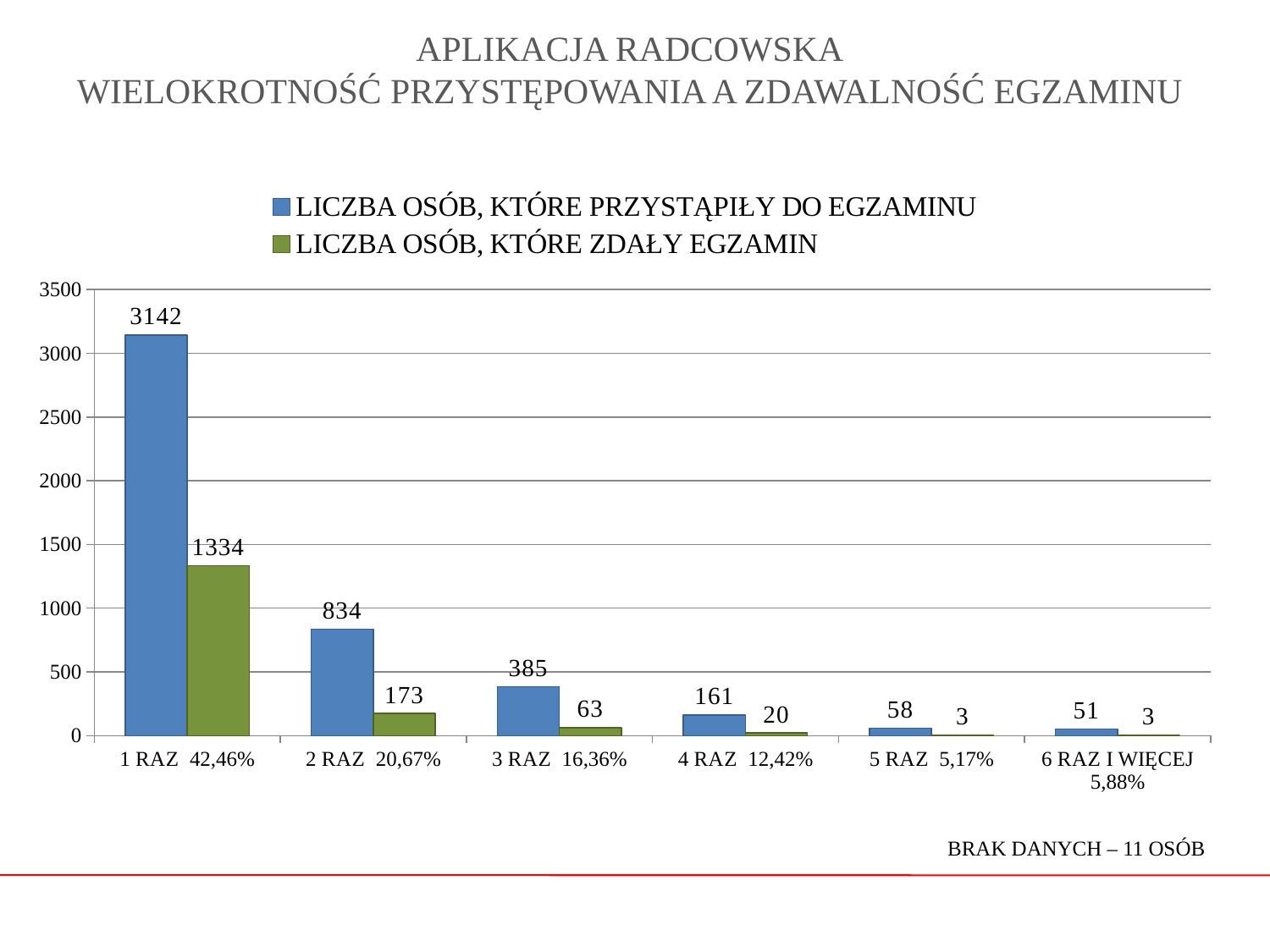
What is the difference between the number of people who took the exam and the number who passed in the 1 RAZ category? 1808 Which category has the lowest number of people who took the exam? 6 RAZ I WIĘCEJ 5,88% What is the number of people who took the exam in the 4 RAZ category? 161 Does the number of people who took the exam rise or fall from 1 RAZ to 6 RAZ I WIĘCEJ? fall What is the difference between the number of people who took the exam in the 2 RAZ category and in the 3 RAZ category? 449 How many people passed the exam in the 2 RAZ category? 173 How many series does the legend list? 2 Which category has the highest number of people who took the exam? 1 RAZ 42,46% Which is larger: the number of people who passed in the 3 RAZ category or in the 4 RAZ category? 3 RAZ How many categories are shown on the x axis? 6 How many people who took the exam for the first time (1 RAZ) are shown in the chart? 3142 What kind of chart is shown on the slide? bar chart